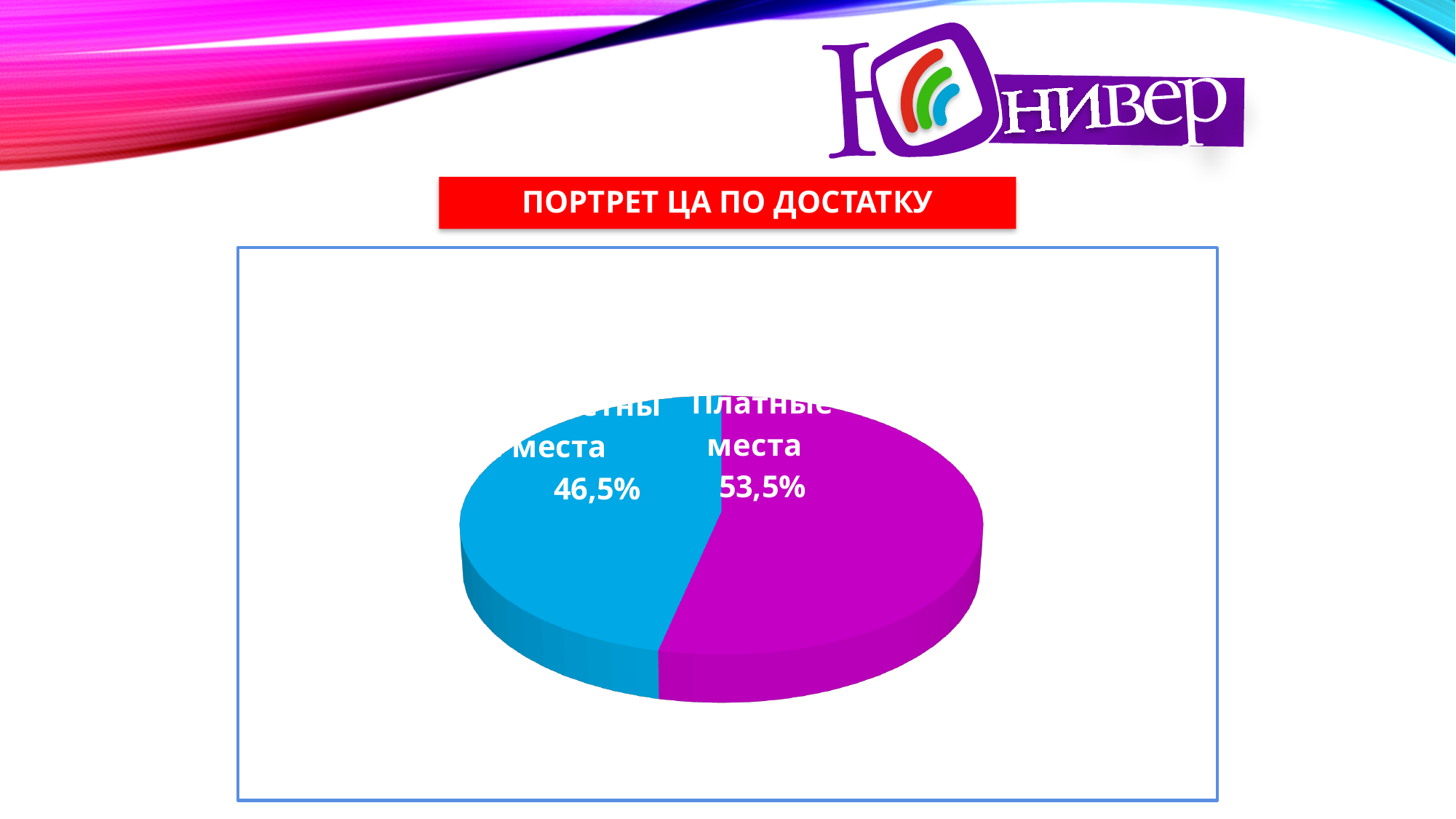
Which slice is smaller, the blue slice or Платные места? the blue slice Which slice of the pie chart is the largest? Платные места Is the share for Платные места greater or less than 50%? greater How many slices does the pie chart have? 2 What percentage does the Платные места slice show? 53,5% What percentage is printed on the blue slice of the pie chart? 46,5% Which is larger: the Платные места slice or the blue slice? Платные места What is the title shown above the chart? ПОРТРЕТ ЦА ПО ДОСТАТКУ What do the two slices of the pie chart add up to? 100% What kind of chart is shown on the slide? pie chart What colour is the Платные места slice? magenta By how many percentage points does Платные места exceed the blue slice? 7%